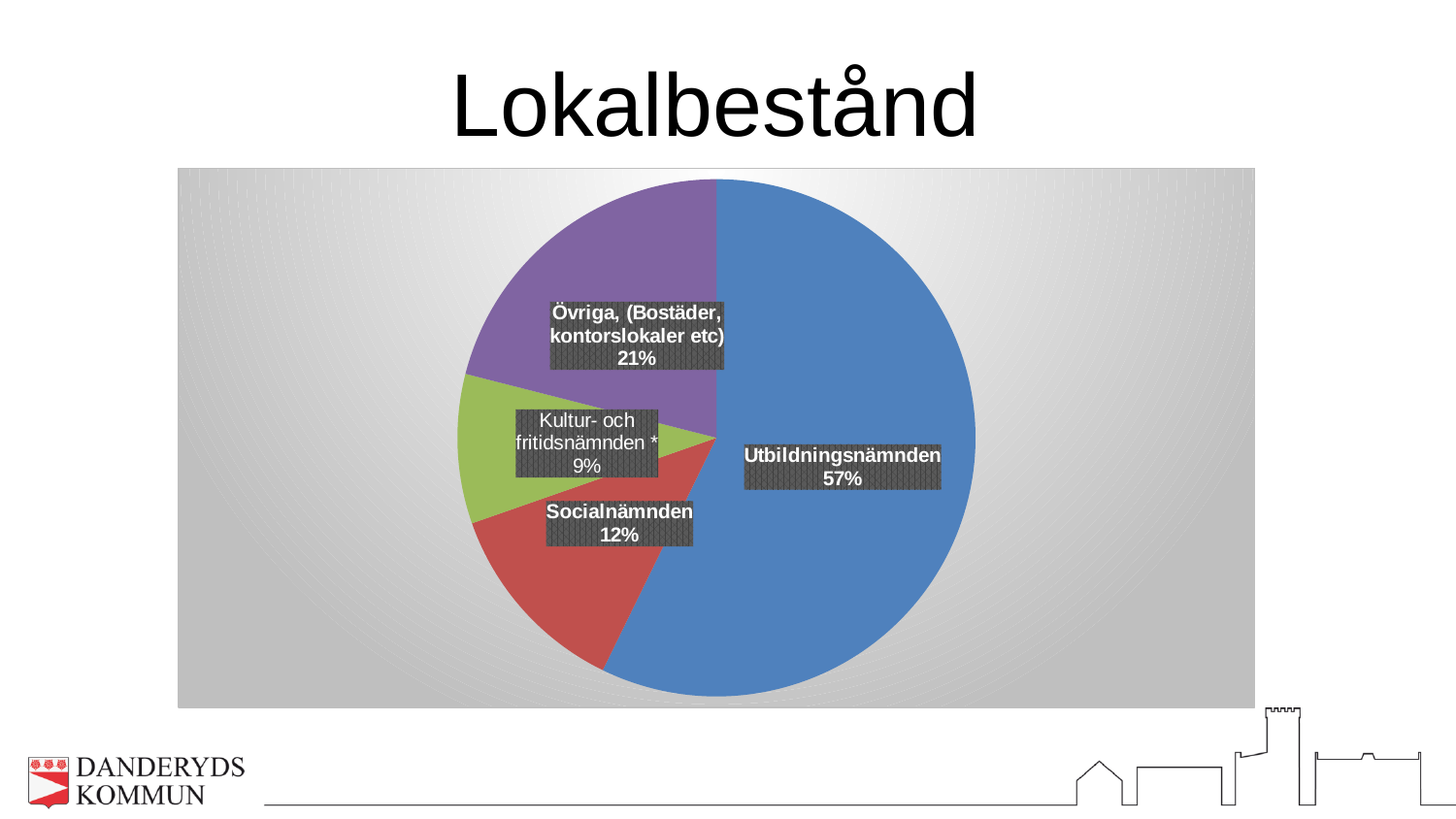
What is the title of the slide containing the pie chart? Lokalbestånd What colour is the Utbildningsnämnden slice? blue What share of the pie does Övriga (Bostäder, kontorslokaler etc) have? 21% Which category has the smallest slice of the pie? Kultur- och fritidsnämnden What kind of chart is shown on the slide? pie chart What share of the pie does Socialnämnden have? 12% Which category has the largest slice of the pie? Utbildningsnämnden What is the difference in percentage points between Utbildningsnämnden and Övriga (Bostäder, kontorslokaler etc)? 36 percentage points How many slices does the pie chart have? 4 What share of the pie does Utbildningsnämnden have? 57% Which is larger, the share for Socialnämnden or the share for Kultur- och fritidsnämnden? Socialnämnden